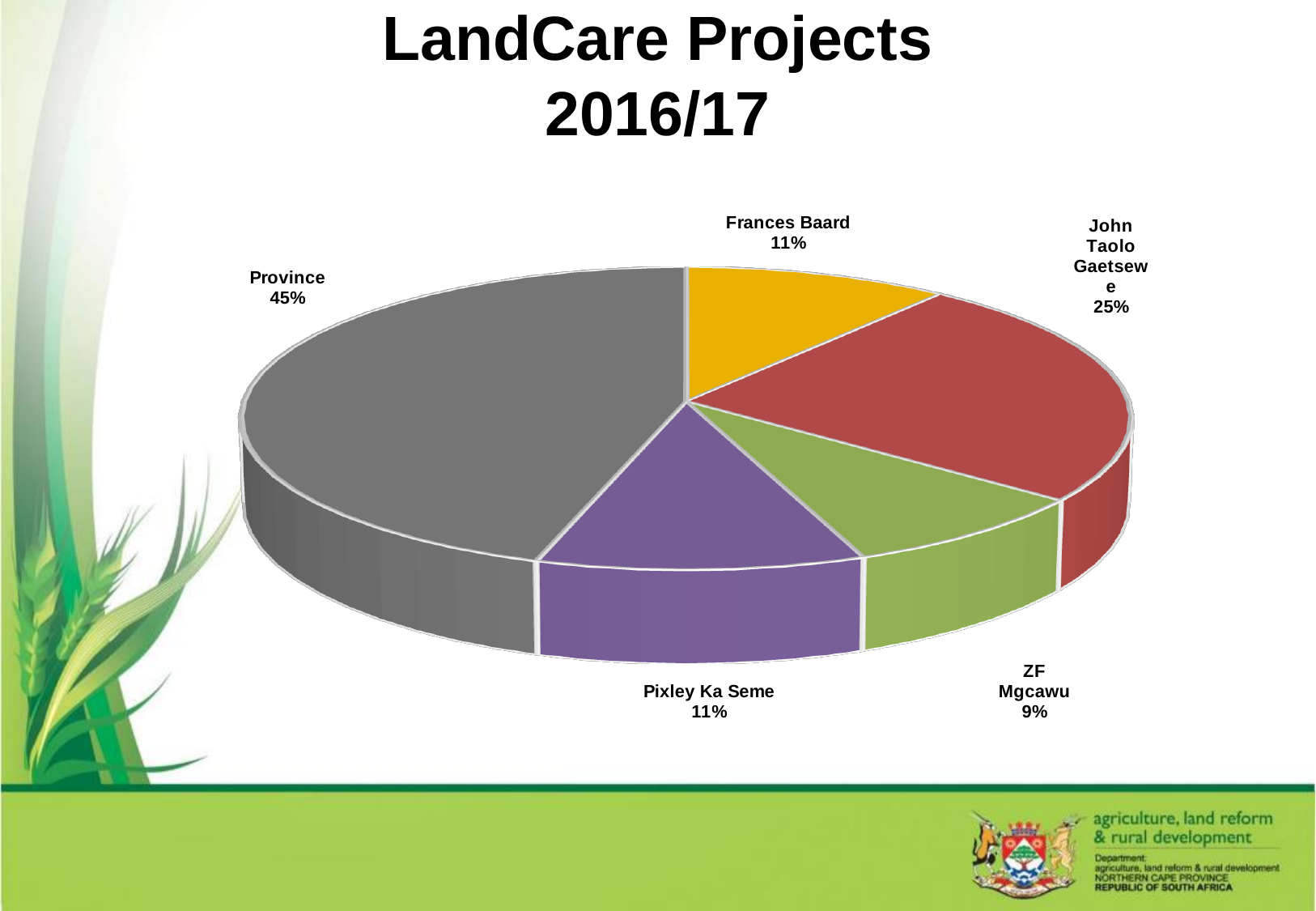
How many slices does the pie chart have? 5 What is the difference in percentage points between Province and John Taolo Gaetsewe? 20 What share of the pie does ZF Mgcawu account for? 9% What kind of chart is shown on the slide? Pie chart What share of the pie does John Taolo Gaetsewe account for? 25% Which category has the smallest slice of the pie? ZF Mgcawu Which category has the largest slice of the pie? Province What share of the pie does Frances Baard account for? 11% What colour is the Province slice of the pie? Grey Which is larger, the share for John Taolo Gaetsewe or the share for Pixley Ka Seme? John Taolo Gaetsewe What is the title of the chart on the slide? LandCare Projects 2016/17 What share of the pie does Province account for? 45%